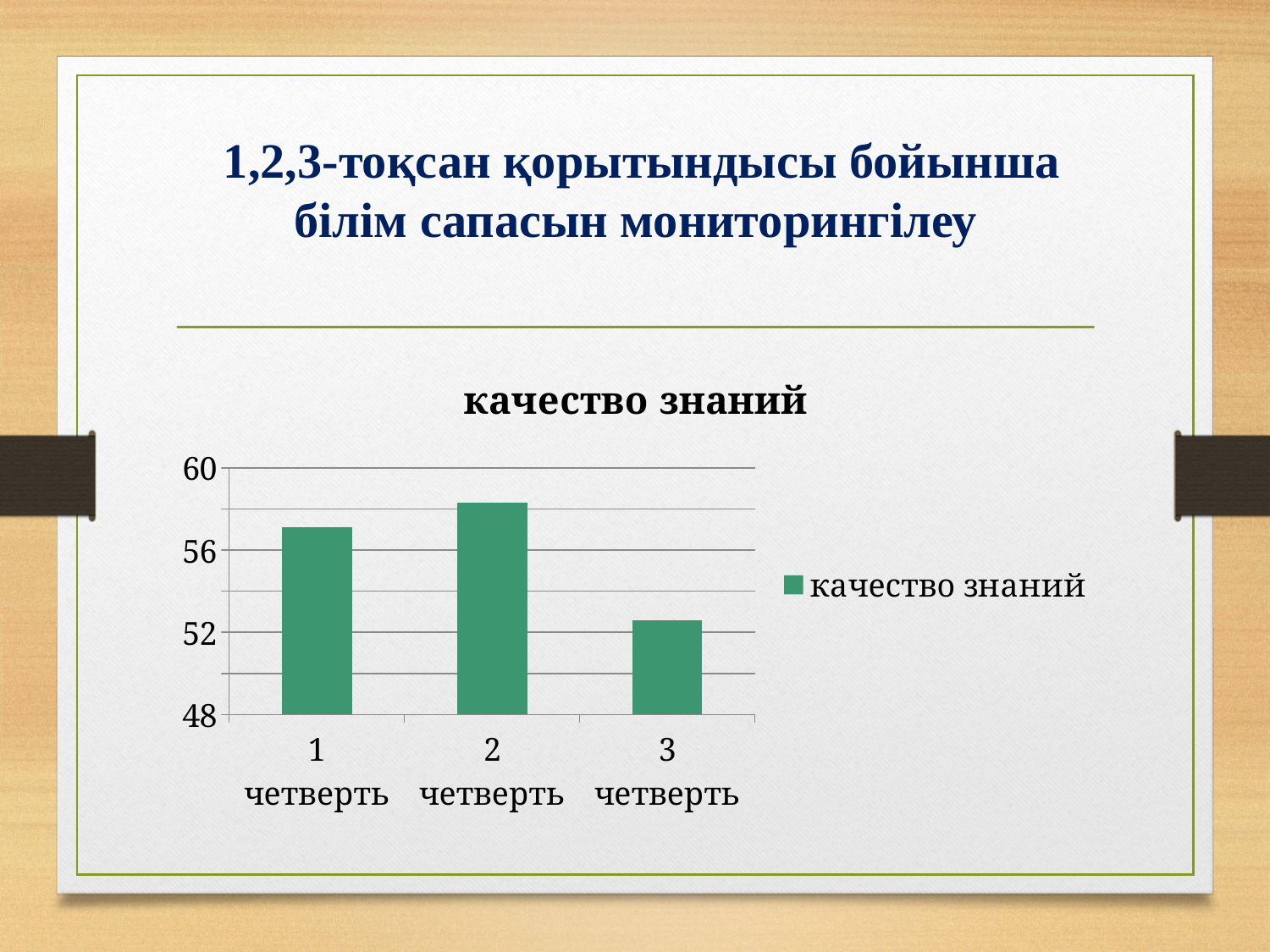
Is the value for 1 четверть greater or less than 56? greater Is the value for 3 четверть greater or less than 56? less Is the value for 2 четверть greater or less than 60? less What is the title of the chart? качество знаний How many series does the chart legend list? 1 What is the name of the series shown in the chart legend? качество знаний What type of chart is shown on the slide? bar chart Which quarter has the lowest value in the chart? 3 четверть Which quarter has the highest value in the chart? 2 четверть How many categories (quarters) are shown on the x axis of the chart? 3 Which is larger, the value for 1 четверть or the value for 3 четверть? 1 четверть